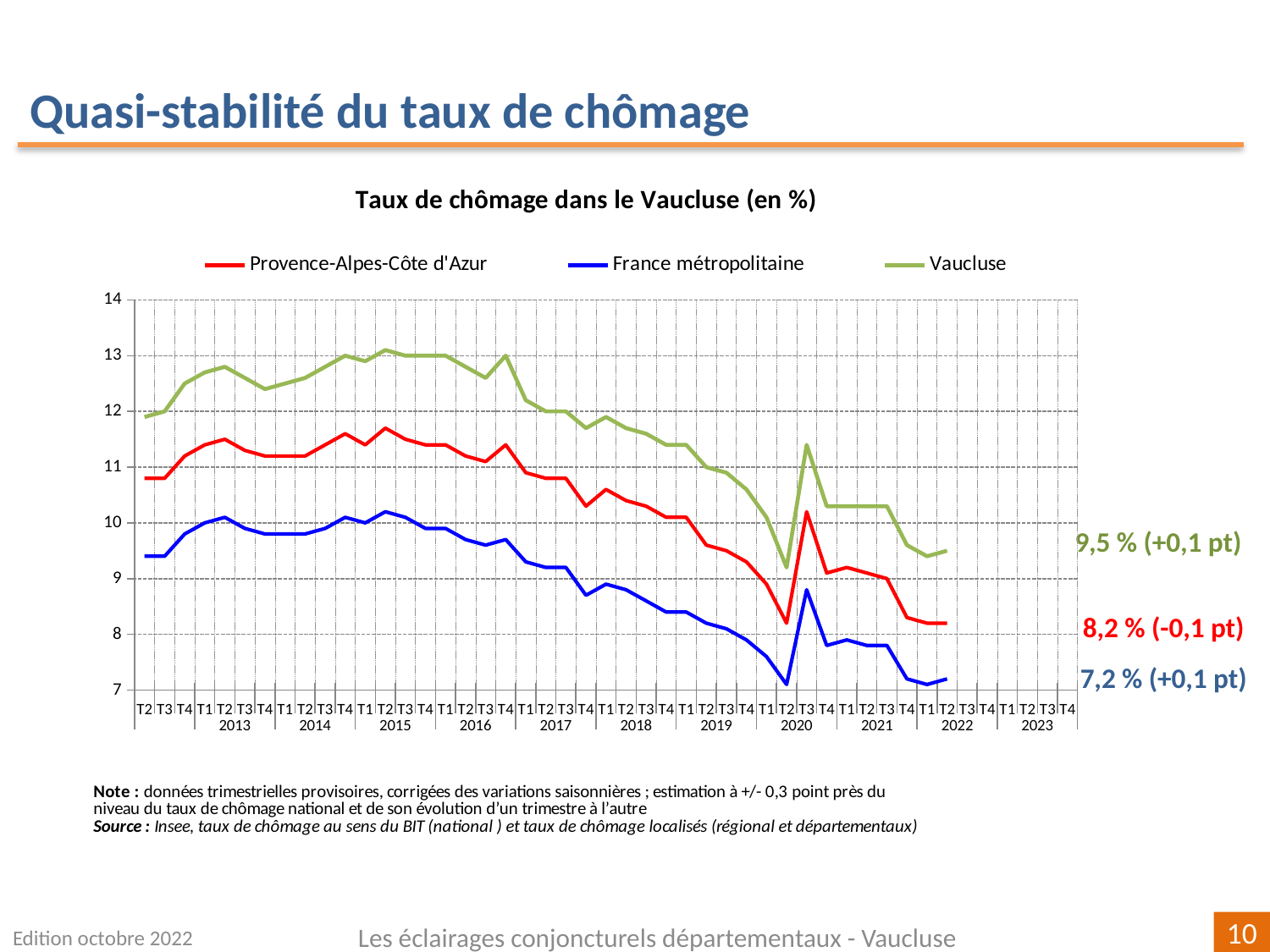
What is the title of the chart? Taux de chômage dans le Vaucluse (en %) What change is indicated next to the latest Provence-Alpes-Côte d'Azur value? -0,1 pt What is the latest unemployment rate shown for France métropolitaine? 7,2 % What is the difference between the latest Vaucluse rate and the latest France métropolitaine rate? 2,3 points Does the Vaucluse unemployment rate rise or fall between 2016 and 2019? fall Which series has the lowest values throughout the chart? France métropolitaine How many series does the legend list? 3 Which series has the highest value at the end of the chart? Vaucluse Is the value for France métropolitaine in T2 2020 greater or less than 8? less What kind of chart is shown on the slide? line chart What is the latest unemployment rate shown for Vaucluse? 9,5 % What is the latest unemployment rate shown for Provence-Alpes-Côte d'Azur? 8,2 %